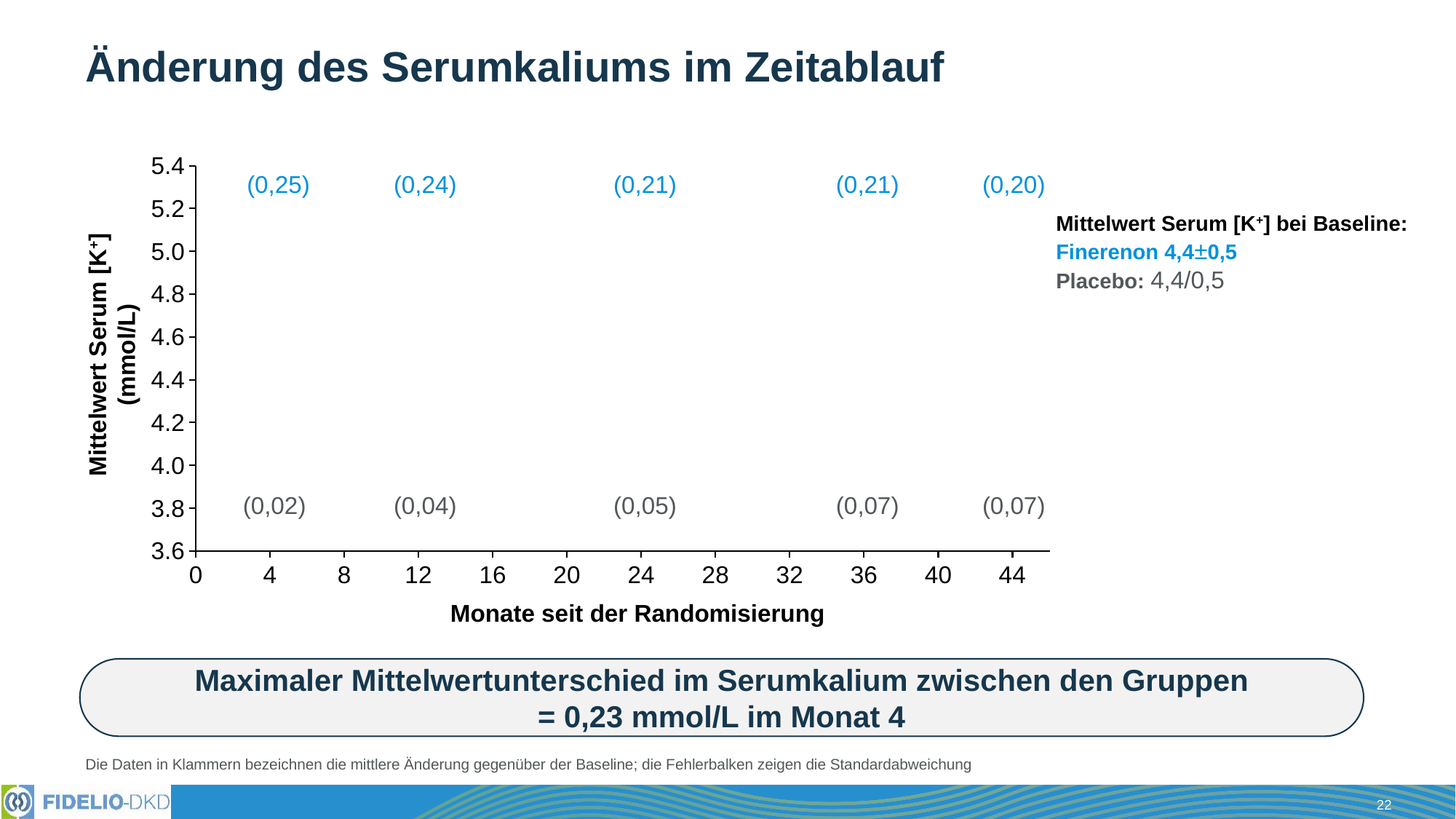
What is the label of the x axis of the chart? Monate seit der Randomisierung At which month is the smallest printed mean change from baseline for Placebo shown? Month 4 Which group has the larger printed mean change from baseline at month 24, Finerenon or Placebo? Finerenon What mean change from baseline (value in parentheses) is printed for Placebo at month 4? (0,02) What is the title of the chart on the slide? Änderung des Serumkaliums im Zeitablauf What mean change from baseline (value in parentheses) is printed for Finerenon at month 4? (0,25) At which month is the largest printed mean change from baseline for Finerenon shown? Month 4 How many time points have printed mean-change values for each group? 5 What mean change from baseline is printed for Placebo at month 36? (0,07) What is the difference between the printed mean changes from baseline for Finerenon and Placebo at month 4? 0,23 What mean change from baseline is printed for Finerenon at month 44? (0,20) Do the printed mean changes from baseline for Placebo rise or fall from month 4 to month 44? Rise